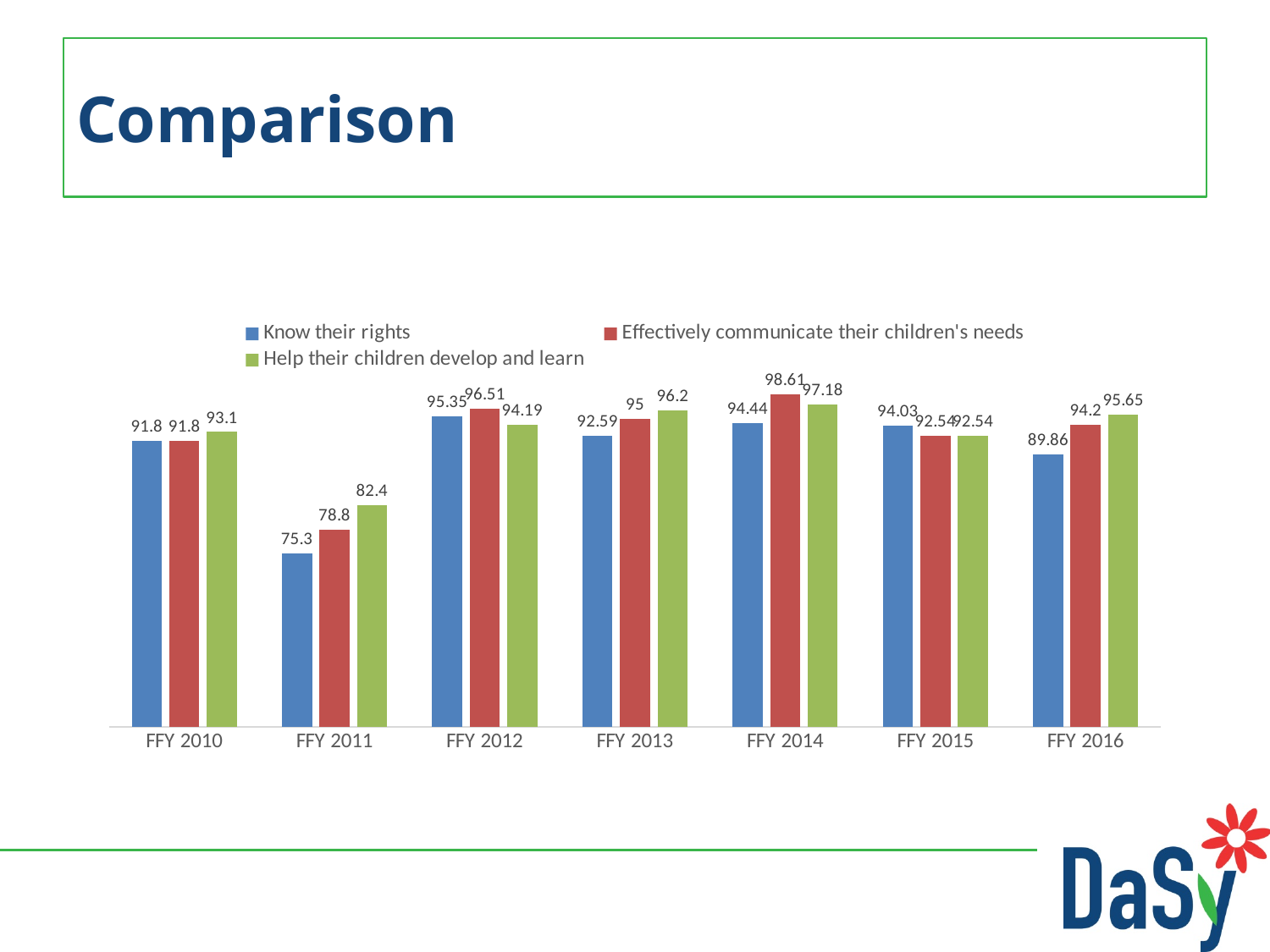
How many years (categories) are shown on the x axis? 7 In FFY 2015, which is larger: "Know their rights" or "Effectively communicate their children's needs"? Know their rights How many series does the legend list? 3 What is the value for "Know their rights" in FFY 2012? 95.35 What is the value for "Effectively communicate their children's needs" in FFY 2014? 98.61 What kind of chart is shown on the slide? Bar chart What is the value for "Know their rights" in FFY 2011? 75.3 In which year is the value for "Know their rights" lowest? FFY 2011 What is the title of the slide containing the chart? Comparison What is the difference between "Help their children develop and learn" and "Know their rights" in FFY 2011? 7.1 In which year is the value for "Effectively communicate their children's needs" highest? FFY 2014 What is the value for "Help their children develop and learn" in FFY 2016? 95.65